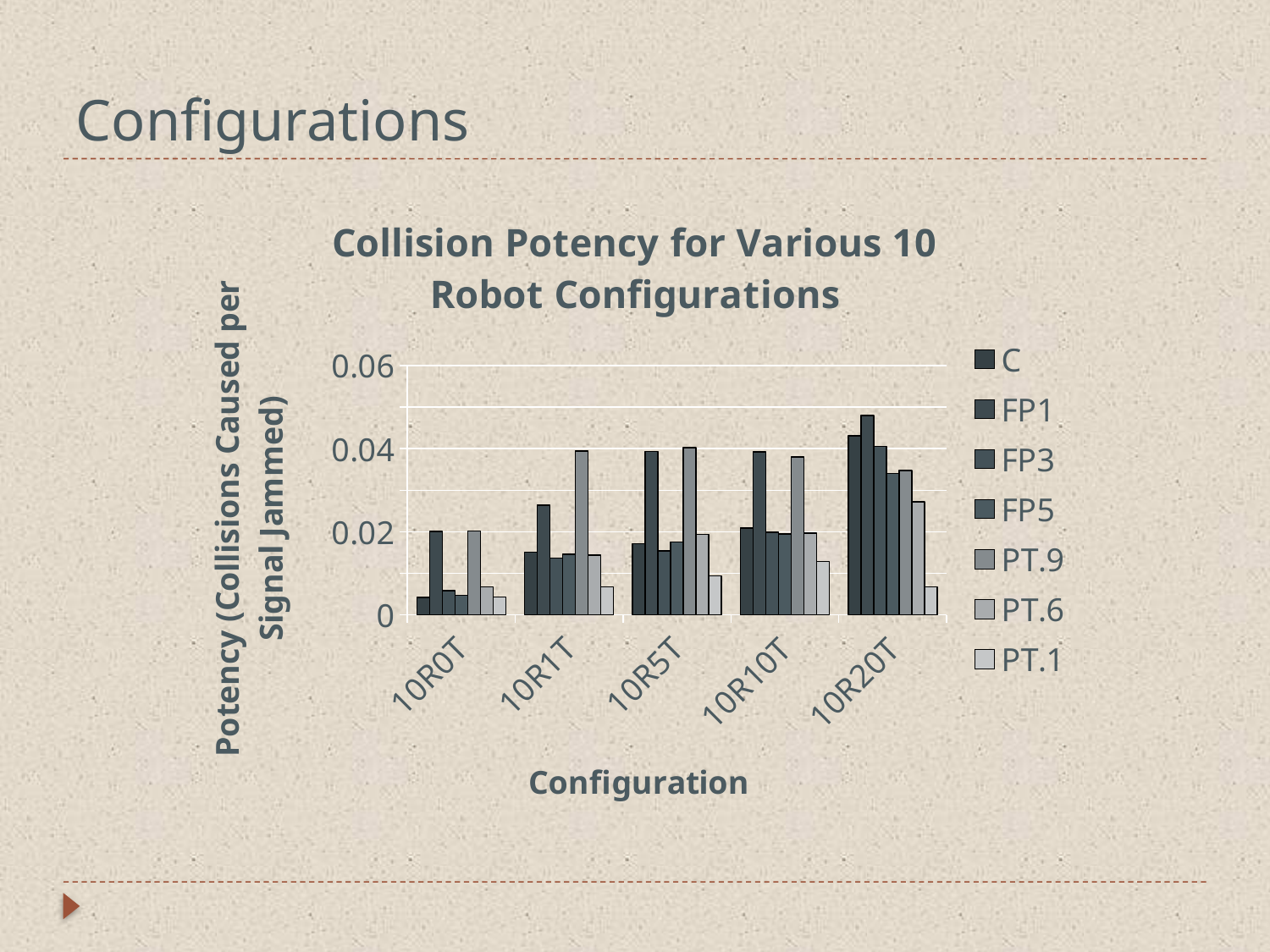
What is the title of the chart? Collision Potency for Various 10 Robot Configurations Is the C value for 10R0T greater or less than 0.02? less Which configuration has the highest FP1 value? 10R20T Does the C series rise or fall from 10R0T to 10R20T along the x axis? rise How many series does the chart's legend list? 7 What kind of chart is shown on the slide? bar chart Is the PT.1 value for 10R20T greater or less than 0.02? less Is the FP1 value for 10R1T greater or less than 0.04? less What is the label of the chart's x axis? Configuration Which configuration has the lowest C value? 10R0T How many configurations are shown on the x axis of the chart? 5